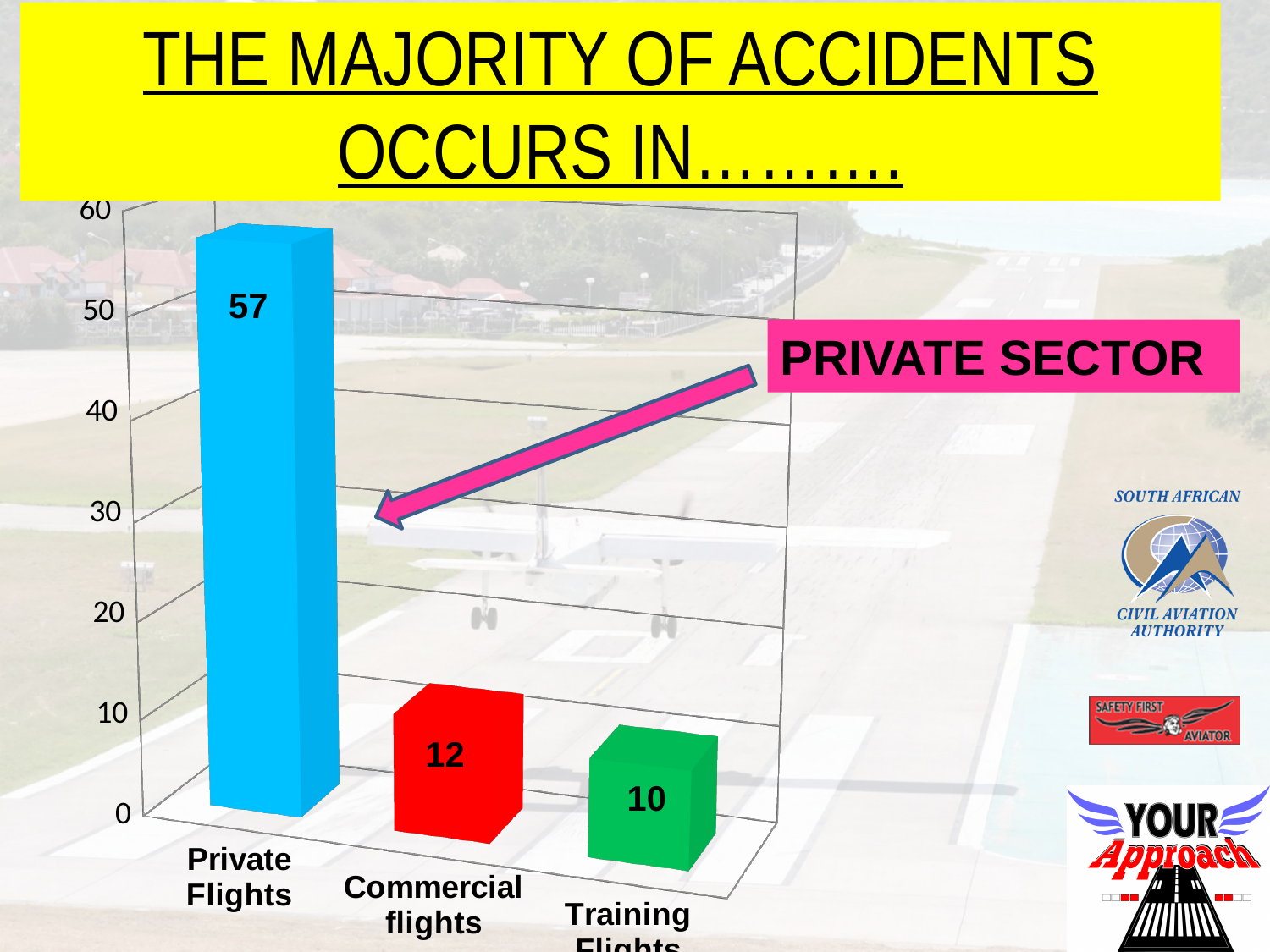
What colour is the bar for Private Flights? blue What is the value for Private Flights? 57 What is the difference between the values for Commercial flights and Training Flights? 2 What kind of chart is shown on the slide? bar chart Is the value for Private Flights greater or less than 50? greater What is the difference between the values for Private Flights and Commercial flights? 45 What is the value for Training Flights? 10 How many categories are shown in the chart? 3 Which category has the highest value? Private Flights What is the value for Commercial flights? 12 Which is larger, the value for Commercial flights or the value for Training Flights? Commercial flights Which category has the lowest value? Training Flights